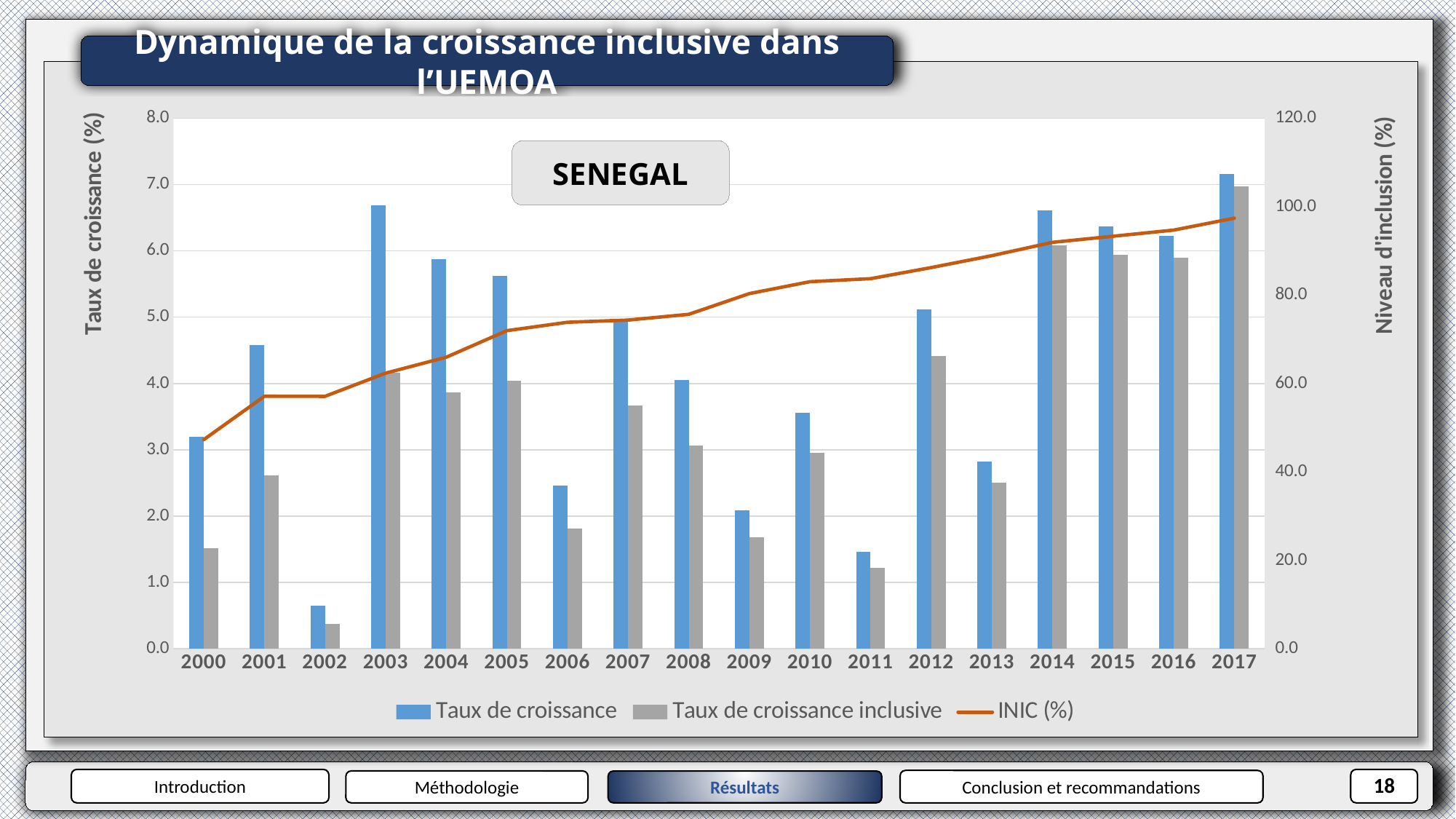
How many years are shown on the x axis of the chart? 18 Is the 'Taux de croissance inclusive' value for 2014 greater or less than 5.0? greater Is the 'Taux de croissance' value for 2003 greater or less than 6.0? greater Does the INIC (%) line generally rise or fall from 2000 to 2017? Rise Which year has the larger 'Taux de croissance' value, 2003 or 2004? 2003 What kind of chart is used for the 'Taux de croissance' and 'Taux de croissance inclusive' series? Bar chart In which year is the 'Taux de croissance' bar the lowest? 2002 Is the 'Taux de croissance' value for 2011 greater or less than 2.0? less In which year is the 'Taux de croissance' bar the highest? 2017 Which country is named in the label box on the chart? SENEGAL How many series does the chart legend list? 3 In which year is the 'Taux de croissance inclusive' bar the highest? 2017